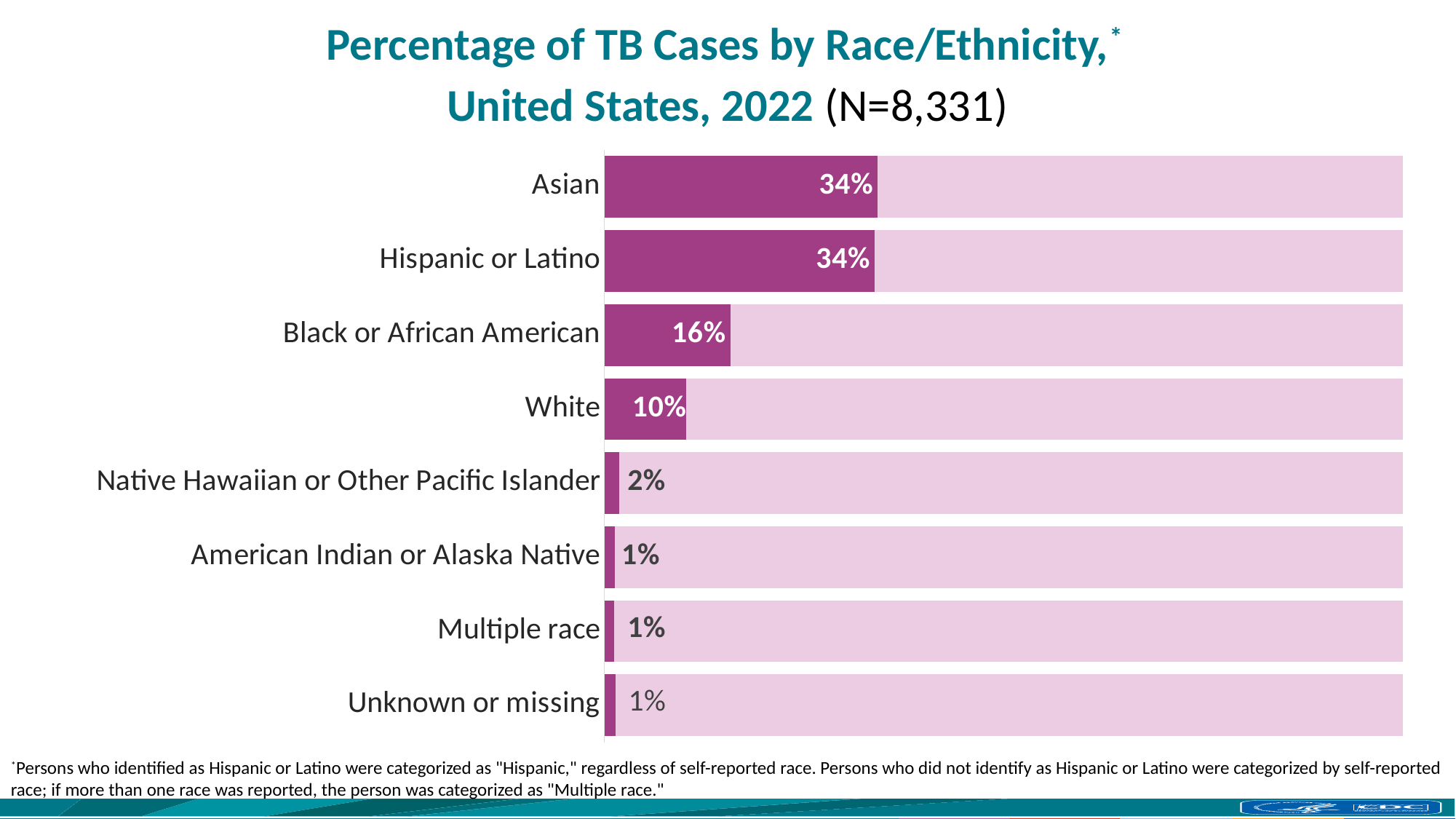
What kind of chart is shown on the slide? Bar chart What percentage of TB cases is shown for Hispanic or Latino? 34% What percentage of TB cases is shown for White? 10% How many race/ethnicity categories are shown in the chart? 8 What is the total number of TB cases (N) given in the chart title? 8,331 What percentage of TB cases is shown for Native Hawaiian or Other Pacific Islander? 2% Which has a larger percentage of TB cases, White or Native Hawaiian or Other Pacific Islander? White Which has a larger percentage of TB cases, Black or African American or White? Black or African American What is the difference in percentage points between Black or African American and White? 6 What percentage of TB cases is shown for Black or African American? 16% What percentage of TB cases is shown for Unknown or missing? 1% What is the difference in percentage points between Asian and Black or African American? 18